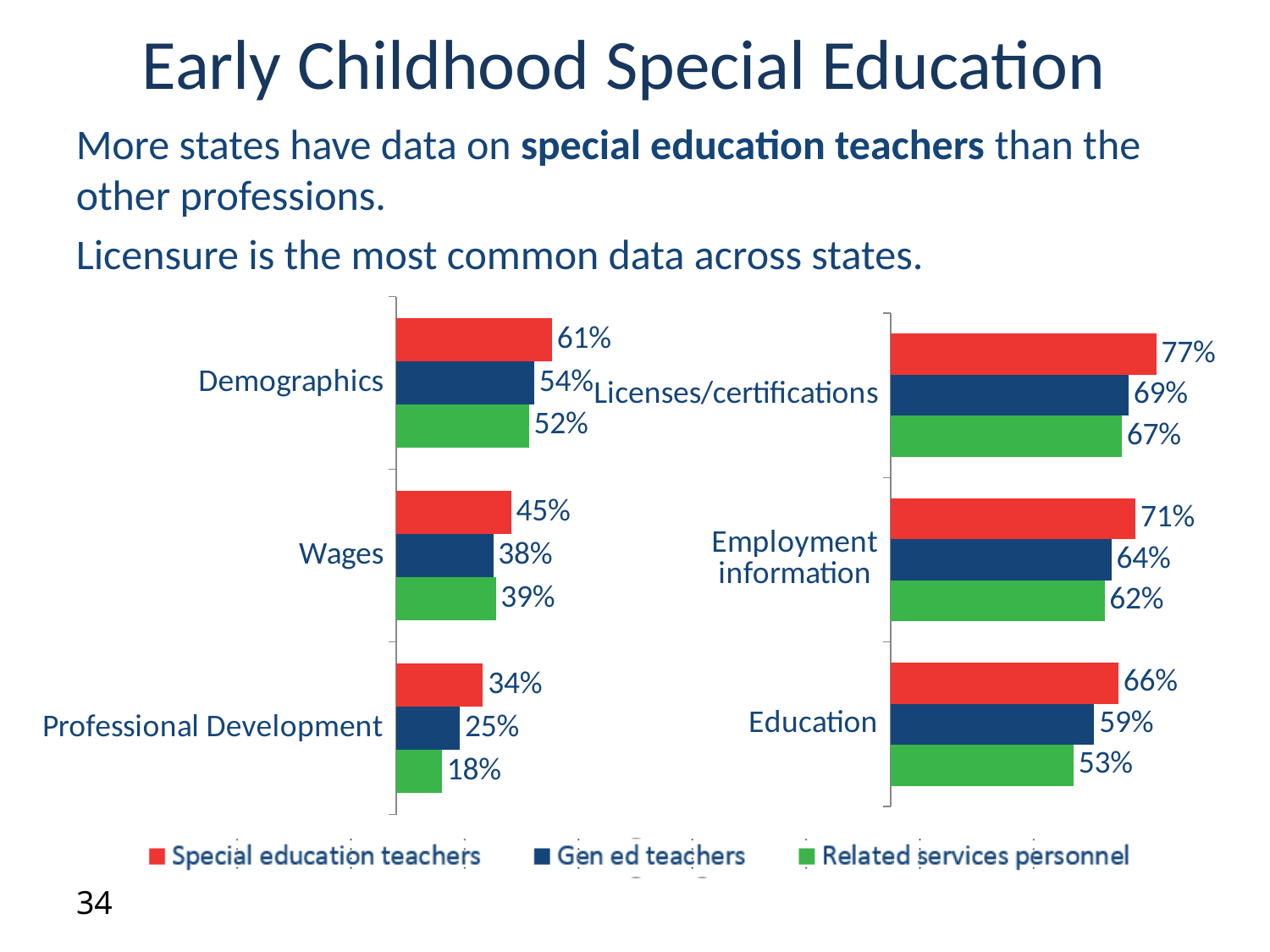
In the right chart, what is the value for Gen ed teachers under Employment information? 64% In the left chart, what is the value for Special education teachers under Demographics? 61% What kind of chart is the right chart? Bar chart In the left chart, which category has the lowest value for Related services personnel? Professional Development How many series does the legend list? 3 In the left chart, which is larger under Demographics: Gen ed teachers or Related services personnel? Gen ed teachers In the right chart, which category has the highest value for Special education teachers? Licenses/certifications In the right chart, what is the difference between Special education teachers and Related services personnel under Education? 13% How many categories does the left chart show? 3 In the right chart, what is the value for Related services personnel under Licenses/certifications? 67% In the left chart, what is the value for Gen ed teachers under Professional Development? 25% In the left chart, what is the difference between Special education teachers and Gen ed teachers under Wages? 7%